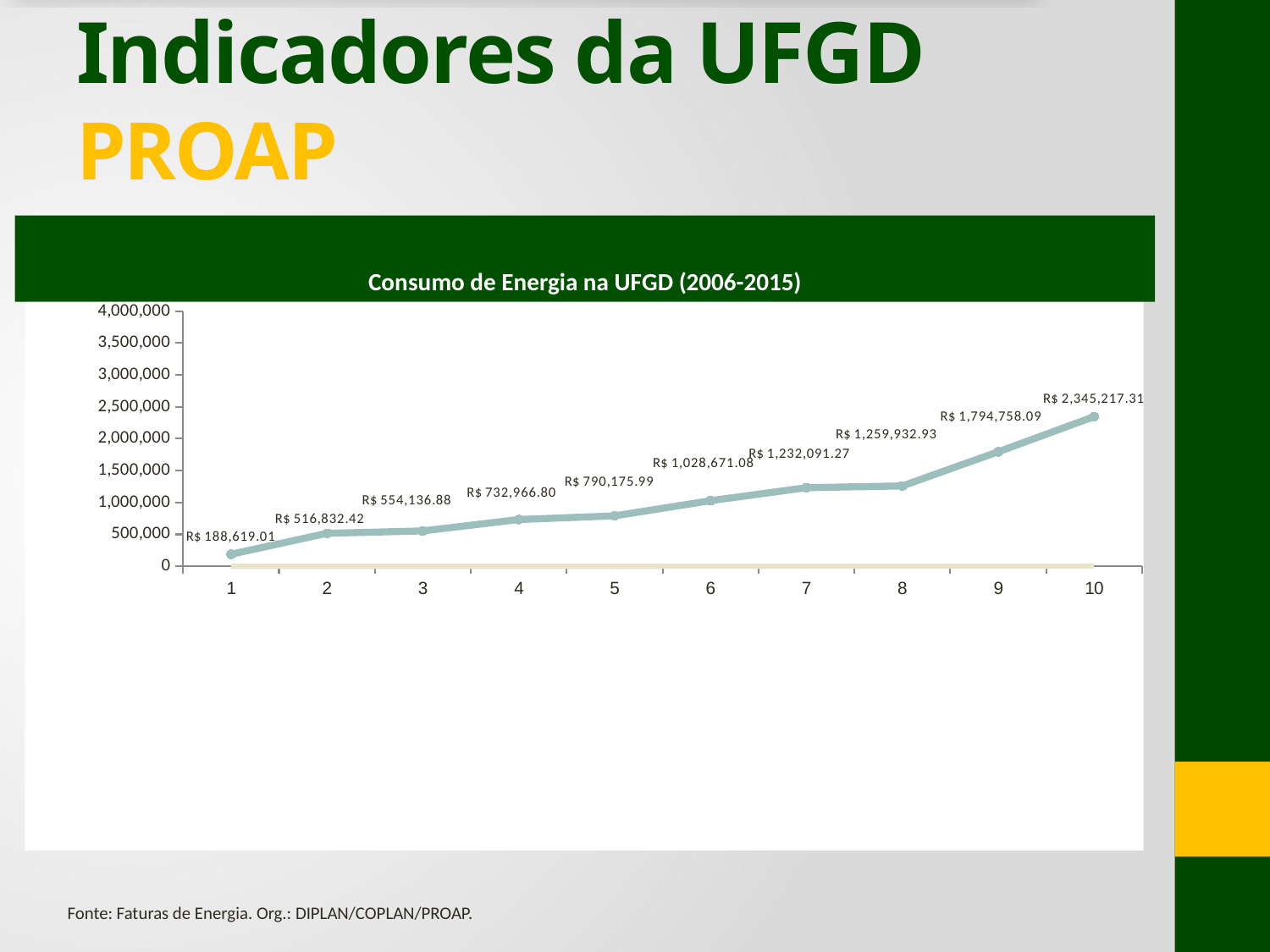
What is the value at point 10 on the x axis? R$ 2,345,217.31 What type of chart is shown on the slide? line chart What is the value at point 1 on the x axis? R$ 188,619.01 What is the difference between the values at point 9 and point 8? R$ 534,825.16 Do the values generally rise or fall from point 1 to point 10? rise How many data points are plotted on the line? 10 What is the difference between the values at point 10 and point 1? R$ 2,156,598.30 What is the value at point 6 on the x axis? R$ 1,028,671.08 What is the title of the chart? Consumo de Energia na UFGD (2006-2015) Which is larger, the value at point 4 or the value at point 7? point 7 Which point on the x axis has the highest value? 10 Which point on the x axis has the lowest value? 1